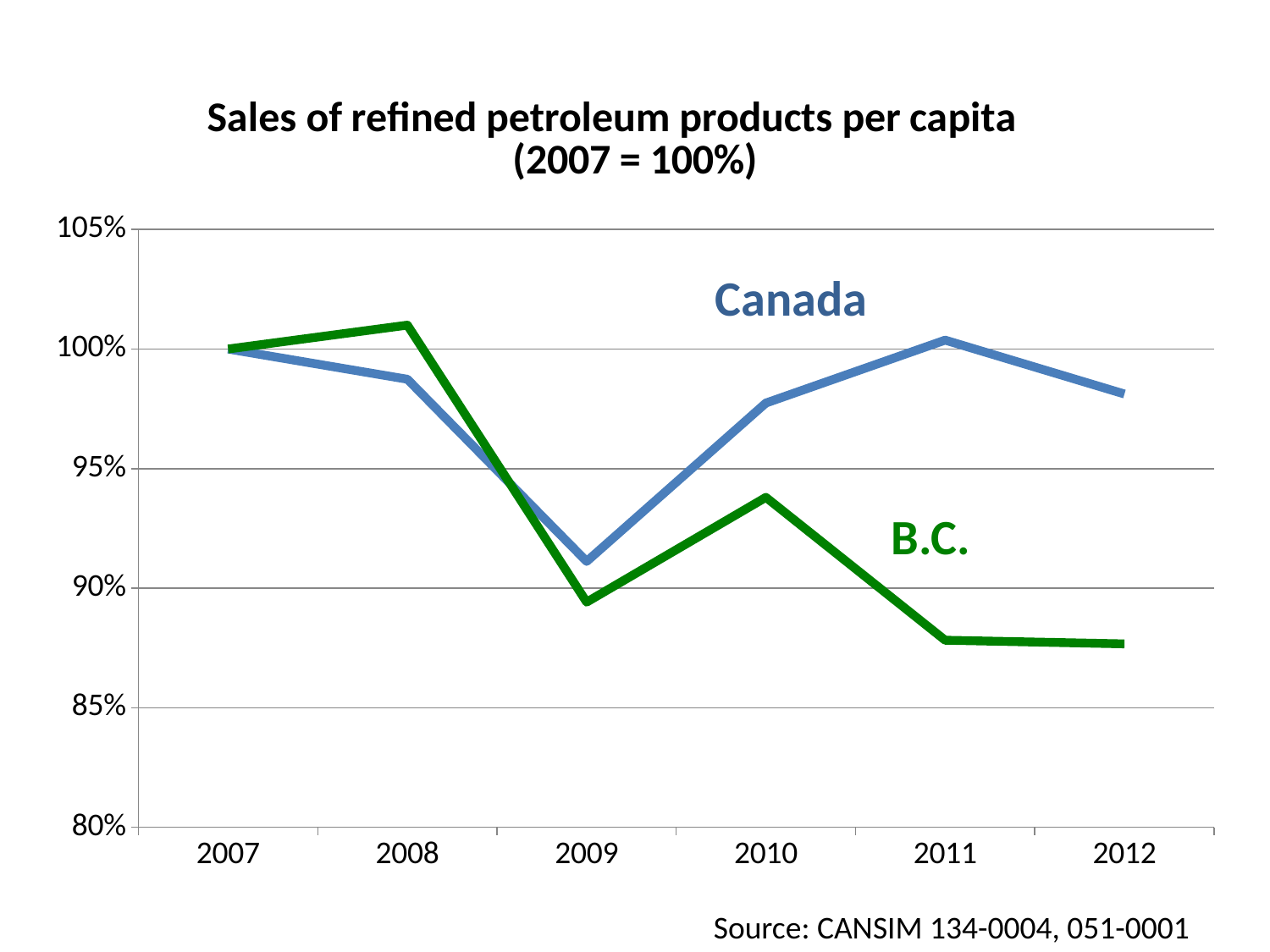
What is the value for Canada in 2007? 100% Does the B.C. line rise or fall from 2010 to 2012? fall What kind of chart is shown on the slide? line chart In which year is the value for B.C. highest? 2008 In 2012, which series has the higher value, Canada or B.C.? Canada Is the value for B.C. in 2010 greater or less than 95%? less Is the value for Canada in 2012 greater or less than 95%? greater In which year is the value for Canada lowest? 2009 How many series are plotted on the chart? 2 Is the value for B.C. in 2012 greater or less than 90%? less What is the title of the chart? Sales of refined petroleum products per capita (2007 = 100%) How many years are shown on the x axis? 6